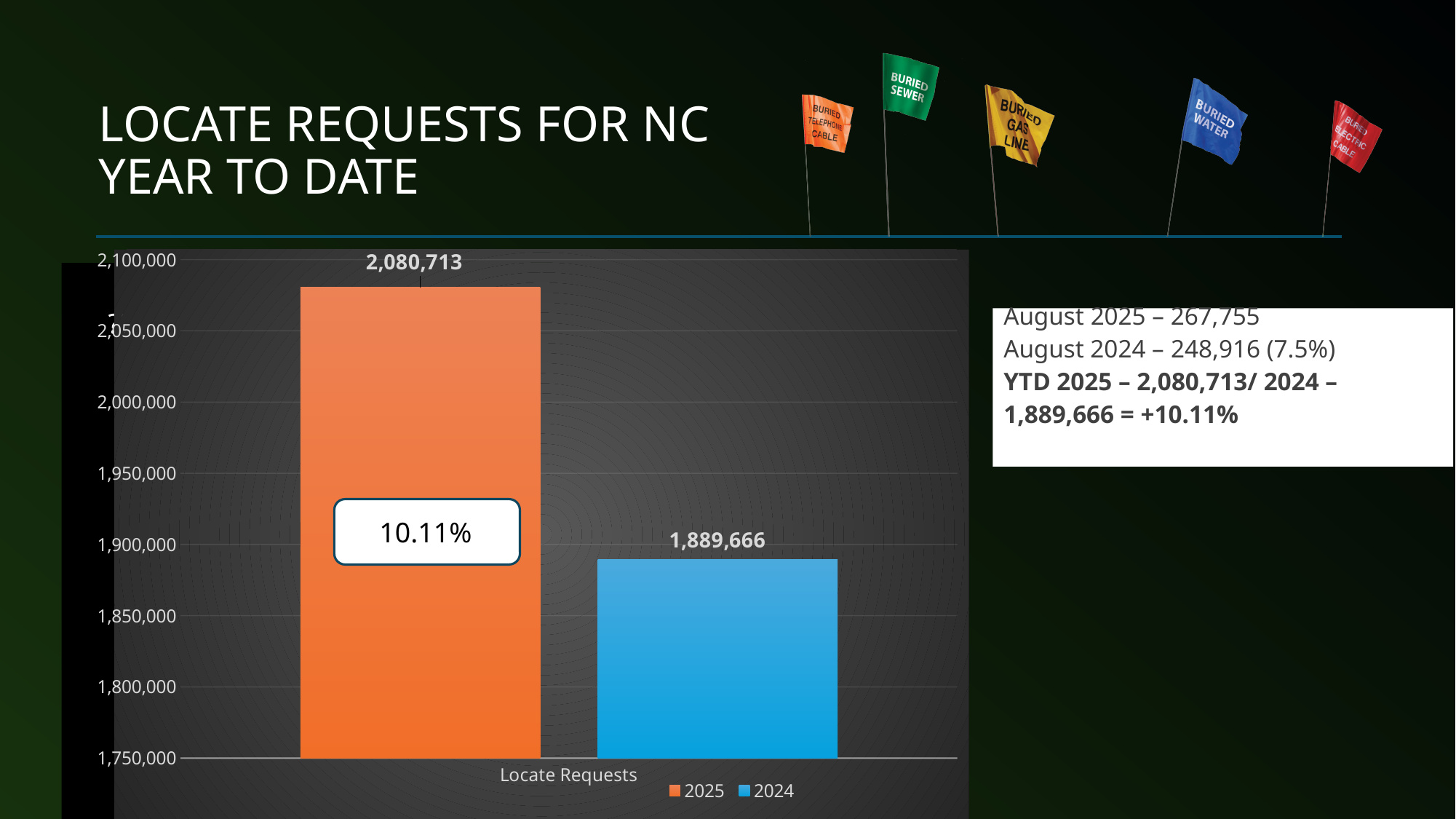
What is the value of the 2025 bar for Locate Requests? 2,080,713 What is the value of the 2024 bar for Locate Requests? 1,889,666 Is the value for 2025 greater or less than 2,050,000? greater What percentage is shown in the callout box on the 2025 bar? 10.11% What is the difference between the 2025 and 2024 values for Locate Requests? 191,047 Which series has the higher value for Locate Requests, 2025 or 2024? 2025 What kind of chart is shown on the slide? bar chart Is the value for 2024 greater or less than 1,900,000? less What is the category label on the x axis of the chart? Locate Requests What colour is the 2024 bar? blue Which series has the lowest value on the chart? 2024 How many series does the legend list? 2